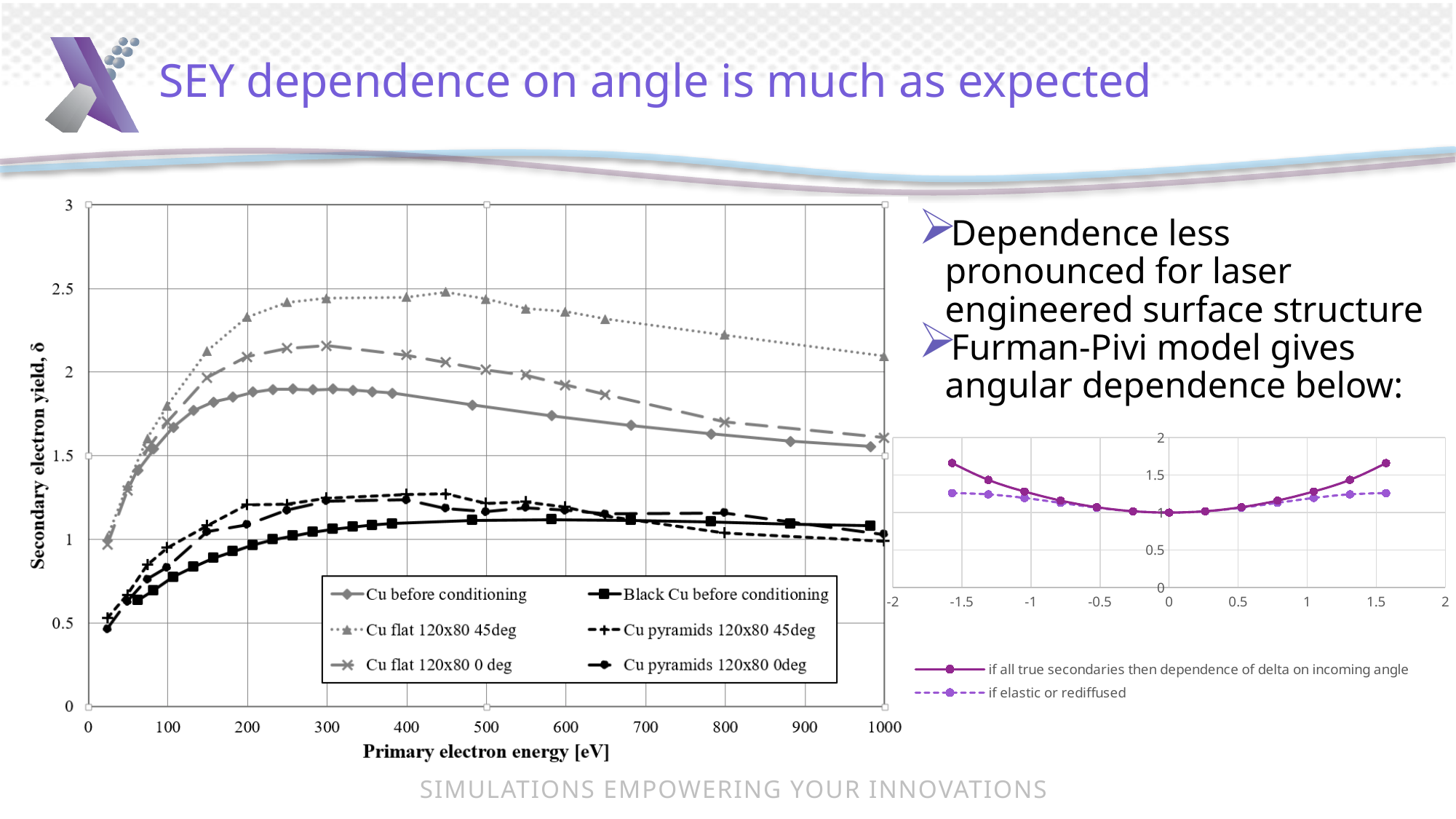
In the left chart, does the Cu before conditioning series rise or fall between 300 eV and 1000 eV? fall In the right chart, is the value of the solid 'if all true secondaries' series at -1.5 greater or less than 1.5? greater In the left chart, is the value for Cu before conditioning at 1000 eV greater or less than 2? less In the left chart, at 300 eV, which is larger: Cu flat 120x80 0 deg or Cu before conditioning? Cu flat 120x80 0 deg What kind of chart is the left chart showing secondary electron yield versus primary electron energy? line chart In the right chart showing angular dependence, how many series does the legend list? 2 What is the x-axis label of the left chart? Primary electron energy [eV] In the left chart, which series has the highest secondary electron yield at 500 eV? Cu flat 120x80 45deg In the left chart, is the value for Black Cu before conditioning at 500 eV greater or less than 1.5? less In the left chart, how many series does the legend list? 6 In the right chart, at 1.5, which series is larger: 'if all true secondaries then dependence of delta on incoming angle' or 'if elastic or rediffused'? if all true secondaries then dependence of delta on incoming angle